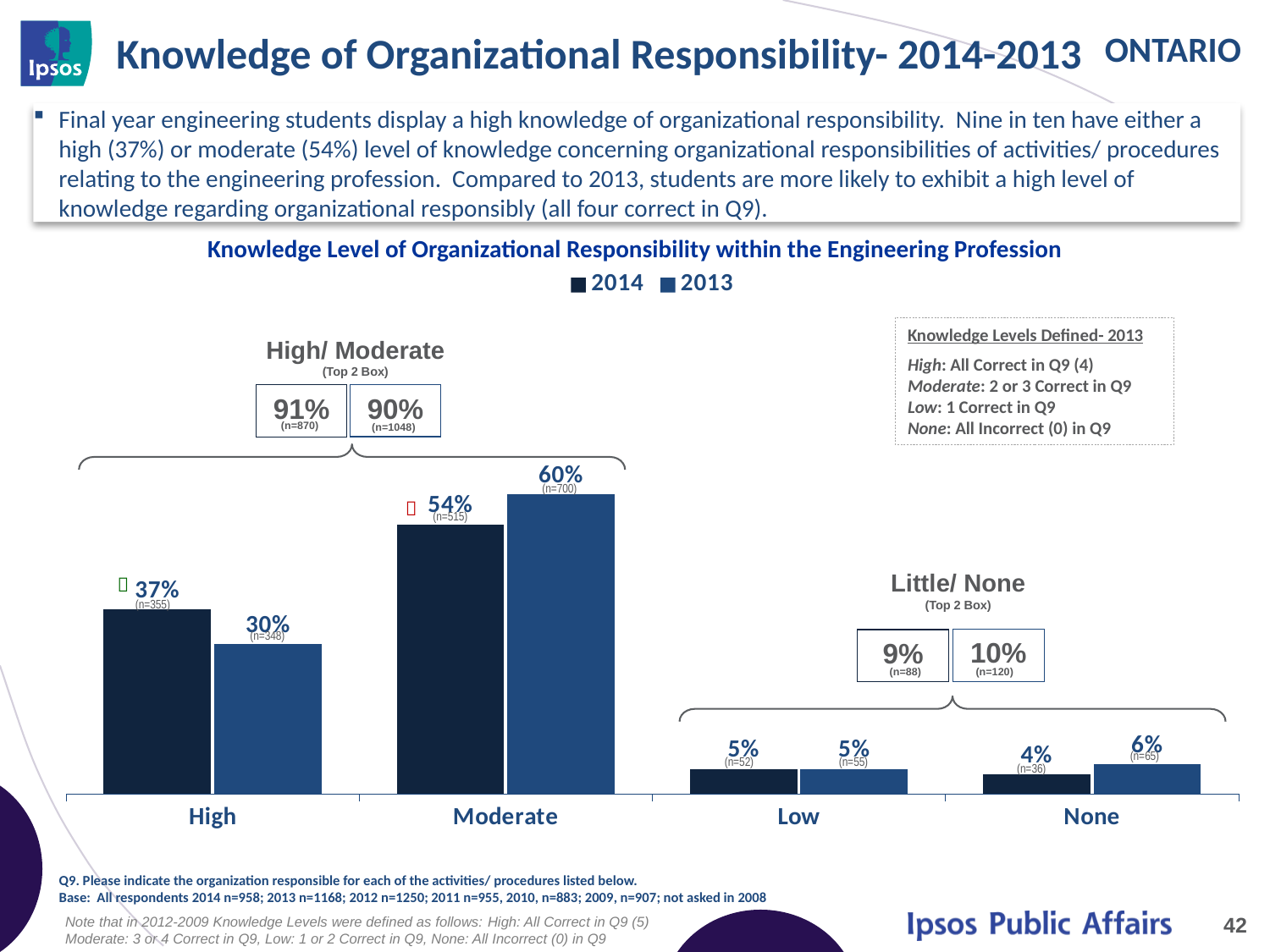
What is the 2013 value for the High category? 30% Which is larger for the High category, the 2014 value or the 2013 value? 2014 Which category has the lowest 2014 value? None What kind of chart is shown on the slide? Bar chart What is the 2014 value for the Low category? 5% How many series does the legend list? 2 What is the 2013 value for the None category? 6% What is the 2014 value for the Moderate category? 54% What is the difference between the 2013 and 2014 values for the Moderate category? 6% Which category has the highest 2014 value? Moderate What is the difference between the 2014 and 2013 values for the High category? 7% How many categories are shown on the x axis? 4